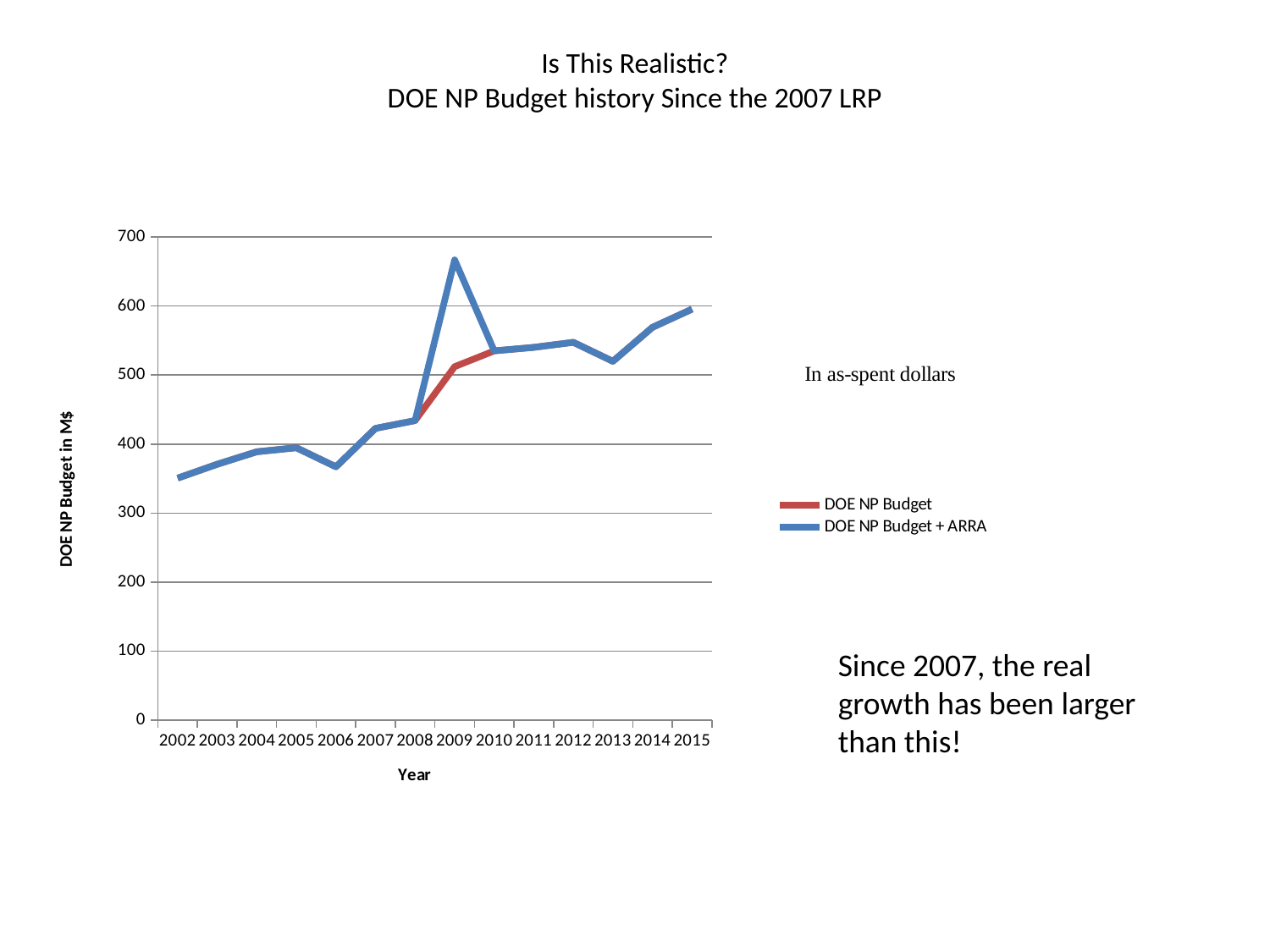
What is the title of the y axis of the chart? DOE NP Budget in M$ Is the DOE NP Budget + ARRA value for 2002 greater or less than 400? less What kind of chart is shown on the slide? line chart How many years are shown on the x axis of the chart? 14 Is the DOE NP Budget + ARRA value for 2009 greater or less than 600? greater Which year has the larger DOE NP Budget + ARRA value, 2009 or 2010? 2009 Is the DOE NP Budget + ARRA value for 2013 greater or less than 500? greater In which year does the DOE NP Budget + ARRA series reach its highest value? 2009 Does the DOE NP Budget + ARRA series rise or fall from 2002 to 2005? rise Which year has the larger DOE NP Budget + ARRA value, 2013 or 2014? 2014 How many series does the legend list? 2 In which year is the DOE NP Budget + ARRA series at its lowest value? 2002